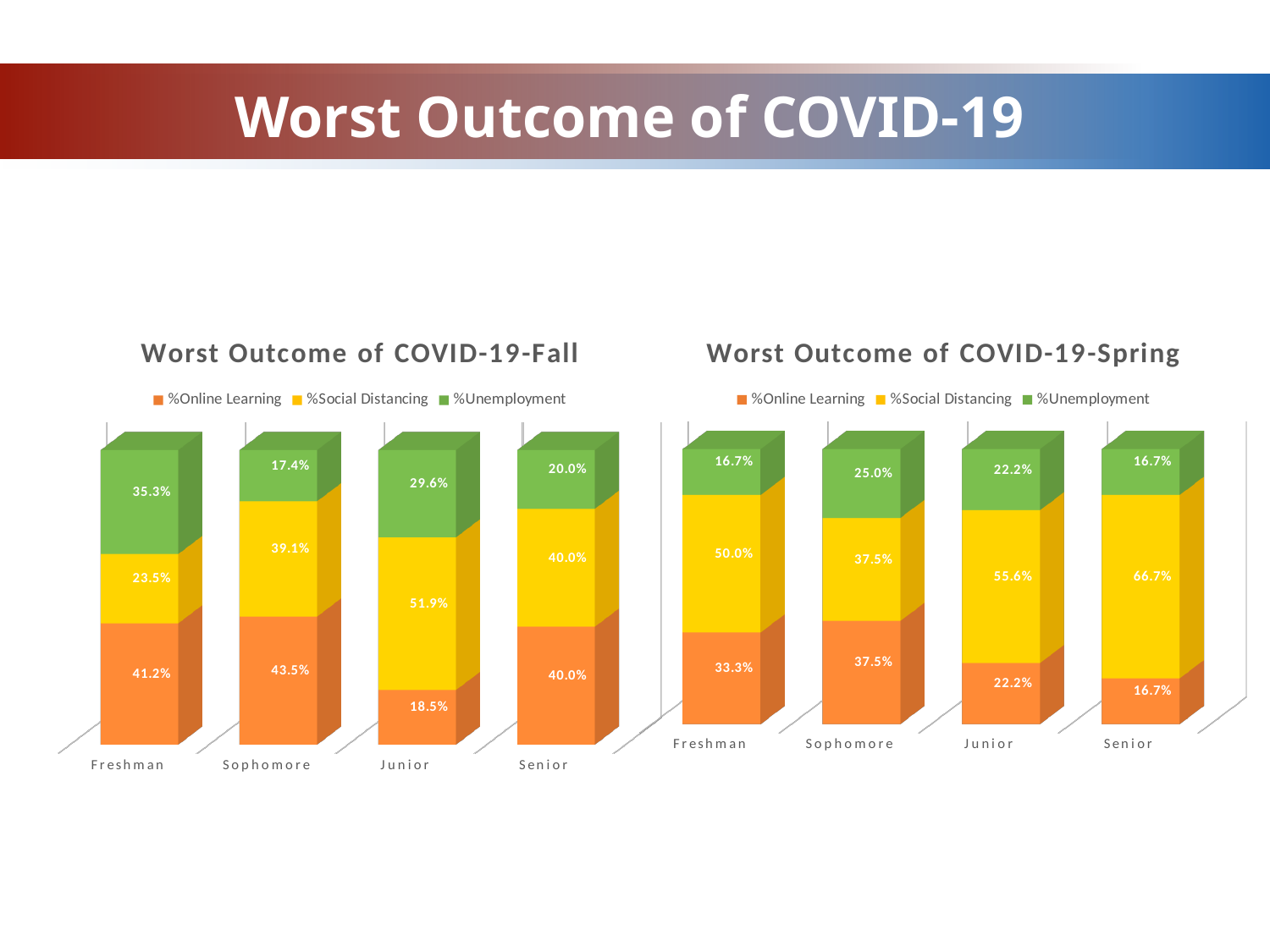
In the 'Worst Outcome of COVID-19-Fall' chart, what is the difference between the %Online Learning values for Sophomore and Junior? 25.0% In the 'Worst Outcome of COVID-19-Spring' chart, what is the %Unemployment value for Sophomore? 25.0% In the 'Worst Outcome of COVID-19-Spring' chart, which class has the lowest %Online Learning value? Senior In the 'Worst Outcome of COVID-19-Spring' chart, what is the %Social Distancing value for Senior? 66.7% What kind of chart is the 'Worst Outcome of COVID-19-Fall' chart? Stacked bar chart In the 'Worst Outcome of COVID-19-Fall' chart, what is the %Online Learning value for Freshman? 41.2% How many series does the legend of the 'Worst Outcome of COVID-19-Spring' chart list? 3 In the 'Worst Outcome of COVID-19-Fall' chart, what is the %Social Distancing value for Junior? 51.9% In the 'Worst Outcome of COVID-19-Spring' chart, what is the total of the stacked bar for Junior? 100.0% In the 'Worst Outcome of COVID-19-Spring' chart, which is larger for Freshman: %Online Learning or %Social Distancing? %Social Distancing How many classes are shown on the x axis of the 'Worst Outcome of COVID-19-Fall' chart? 4 In the 'Worst Outcome of COVID-19-Fall' chart, which class has the highest %Unemployment value? Freshman